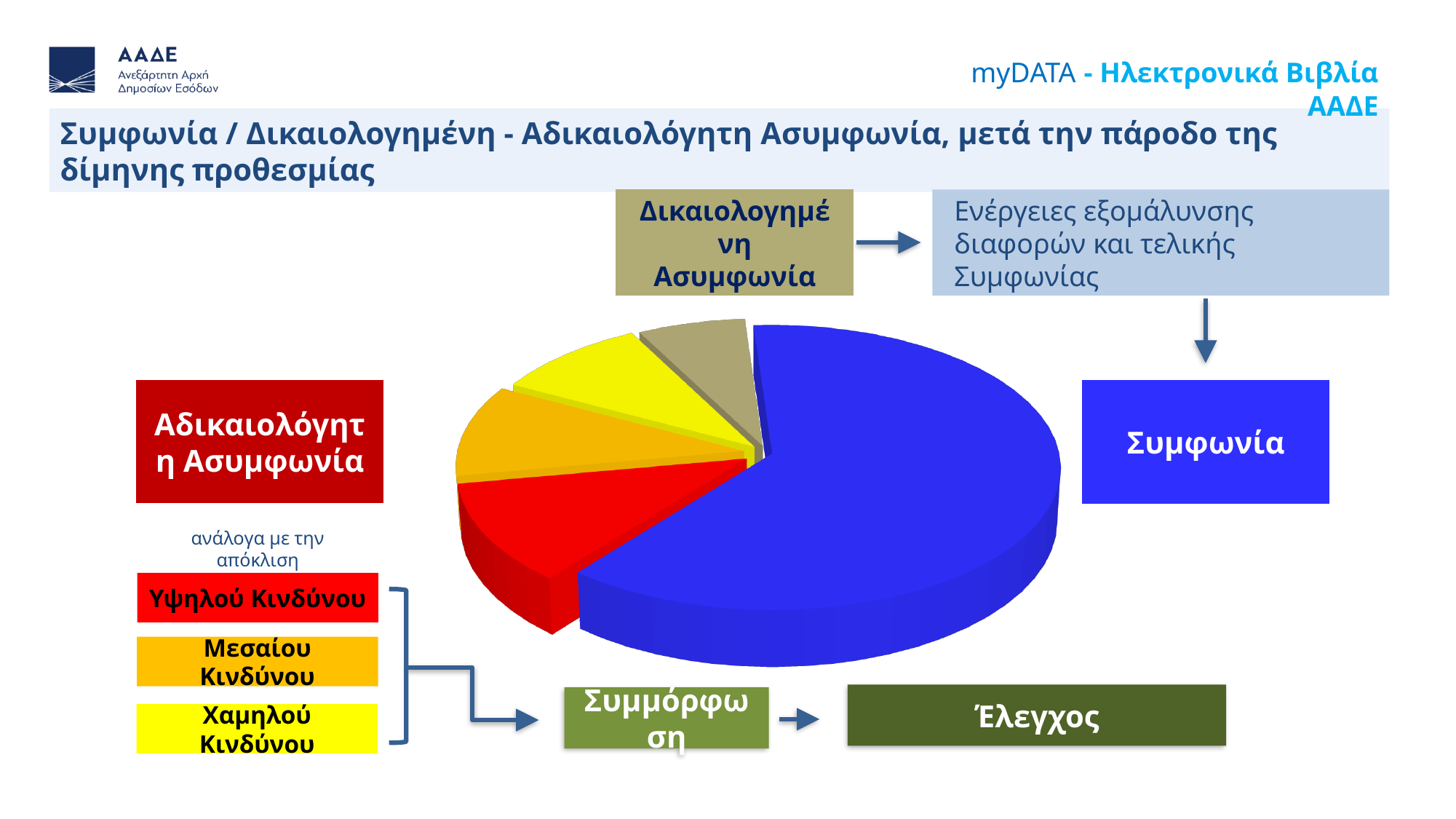
Which slice is larger, Συμφωνία (blue) or Υψηλού Κινδύνου (red)? Συμφωνία Which category has the largest slice of the pie chart? Συμφωνία How many slices does the pie chart have? 5 Which slice is larger, Υψηλού Κινδύνου (red) or Χαμηλού Κινδύνου (yellow)? Υψηλού Κινδύνου What colour is the slice representing Συμφωνία? blue Does the Συμφωνία slice take up more or less than half of the pie? more What kind of chart is shown on the slide? pie chart Which slice is larger, Συμφωνία (blue) or Δικαιολογημένη Ασυμφωνία (khaki)? Συμφωνία What colour is the slice representing Υψηλού Κινδύνου? red